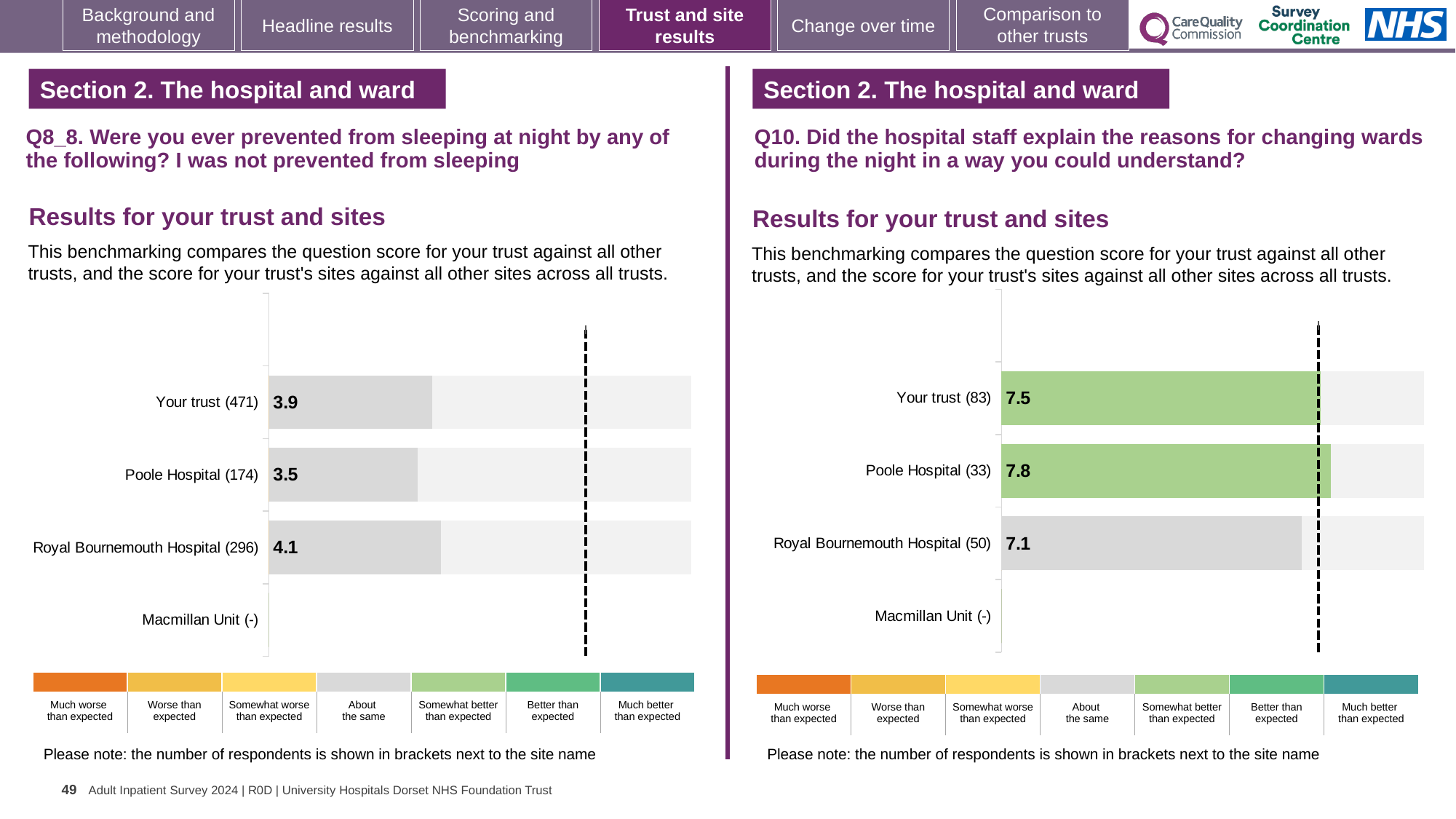
In the left chart (Q8_8), what is the score for Poole Hospital? 3.5 In the left chart (Q8_8), what is the score for Your trust? 3.9 In the left chart (Q8_8), which site has the highest score? Royal Bournemouth Hospital In the right chart (Q10), what is the difference between the scores for Poole Hospital and Your trust? 0.3 In the right chart (Q10), what is the score for Royal Bournemouth Hospital? 7.1 In the left chart (Q8_8), how many respondents are shown for Your trust? 471 In the right chart (Q10), what is the score for Your trust? 7.5 In the right chart (Q10), what colour are the bars for Your trust and Poole Hospital? Green In the left chart (Q8_8), what is the difference between the scores for Royal Bournemouth Hospital and Poole Hospital? 0.6 In the right chart (Q10), which has the larger score, Poole Hospital or Your trust? Poole Hospital In the right chart (Q10), which site has the lowest score? Royal Bournemouth Hospital What kind of chart is used on the left side of the slide (Q8_8)? Bar chart